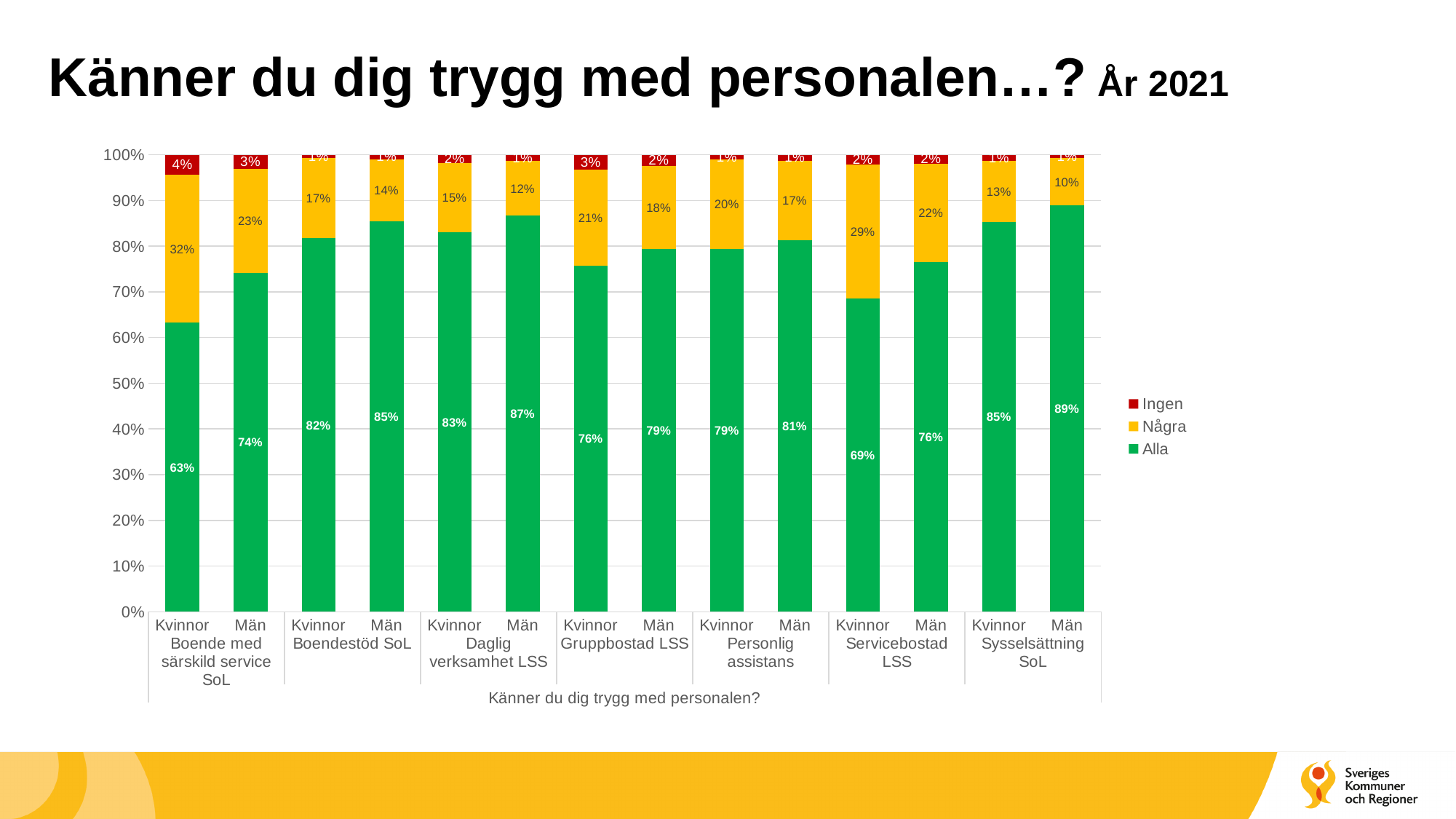
How many series does the legend list? 3 What is the "Några" value for women (Kvinnor) in Servicebostad LSS? 29% What is the difference between the "Alla" values for men and women in Servicebostad LSS? 7 percentage points Which bar has the highest "Alla" value? Män, Sysselsättning SoL (89%) What type of chart is shown on the slide? Stacked bar chart Which series is shown in red in the legend? Ingen Which bar has the lowest "Alla" value? Kvinnor, Boende med särskild service SoL (63%) What is the "Ingen" value for men (Män) in Boende med särskild service SoL? 3% Which is larger: the "Alla" value for women in Daglig verksamhet LSS or for women in Gruppbostad LSS? Women in Daglig verksamhet LSS (83%) What is the "Några" value for men (Män) in Sysselsättning SoL? 10% How many bars are shown in the chart? 14 What percentage of women (Kvinnor) in Boende med särskild service SoL answered "Alla"? 63%